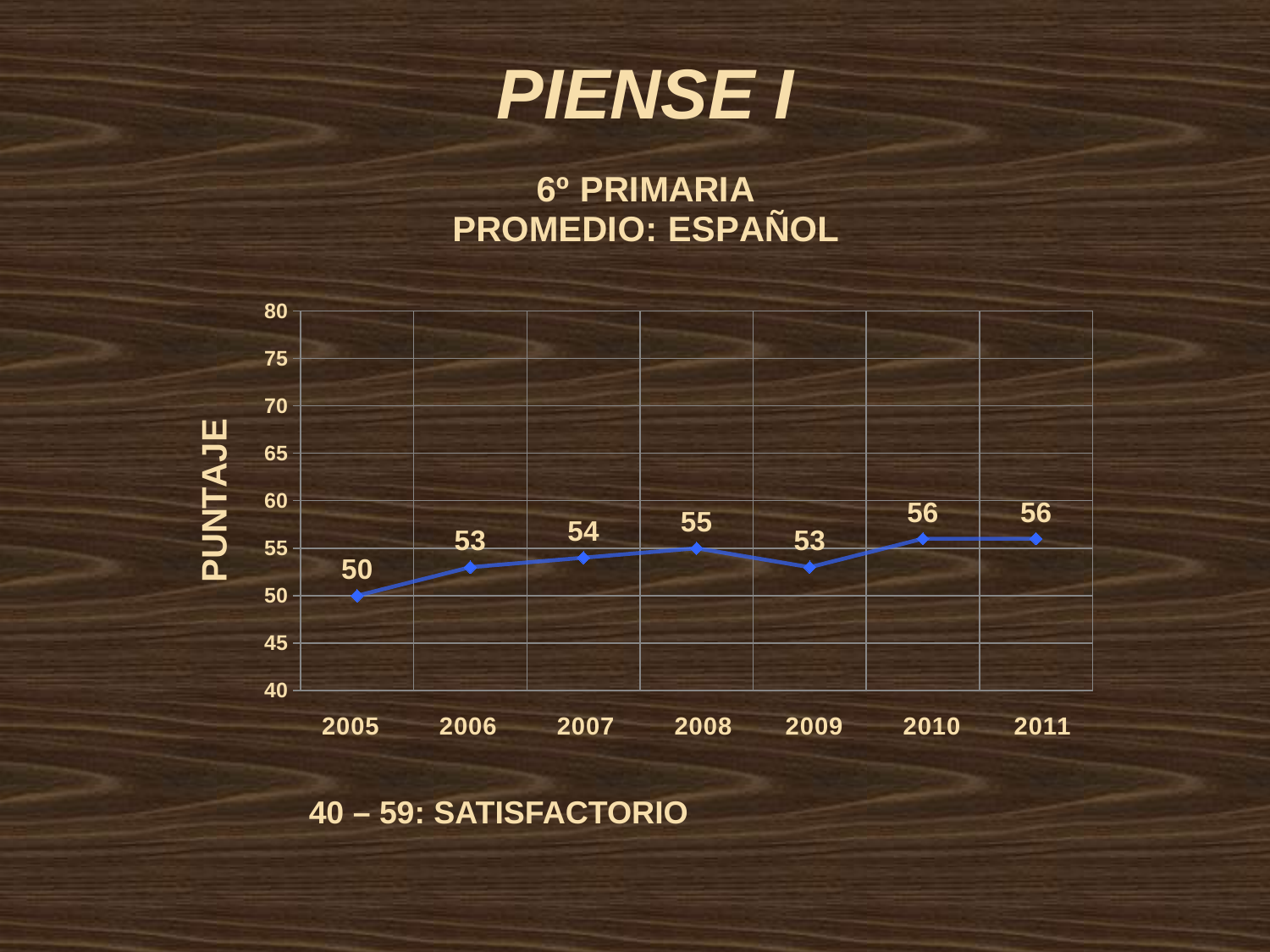
What is the difference between the values for 2007 and 2006? 1 Which is larger, the value for 2008 or the value for 2009? 2008 Do the values generally rise or fall from 2005 to 2011? rise Is the value for 2010 greater or less than 60? less What kind of chart is shown? line chart What is the value for 2008? 55 Which year has the lowest value? 2005 What is the difference between the values for 2011 and 2005? 6 What is the value for 2009? 53 How many years are plotted on the chart? 7 What is the value for 2005? 50 What is the label on the vertical axis? PUNTAJE